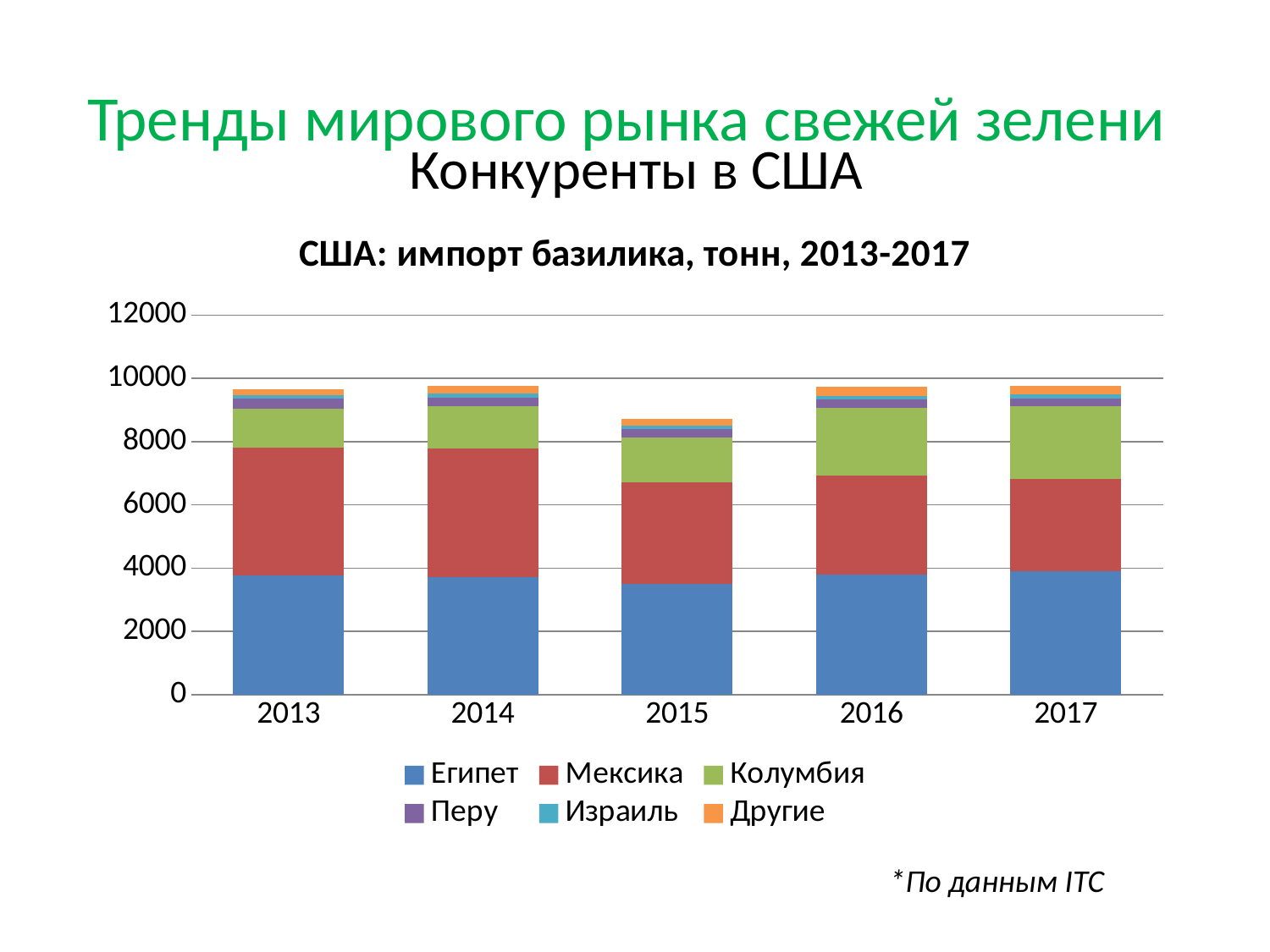
What kind of chart is shown on the slide? Stacked bar chart Which country forms the bottom segment of each stacked bar? Египет How many years are shown on the x axis of the chart? 5 Which year has the larger Колумбия segment, 2013 or 2017? 2017 Which year has the lowest total basil import? 2015 Is the total import for 2015 greater or less than 8000? greater Is the Египет segment for 2015 greater or less than 4000? less What is the title of the chart? США: импорт базилика, тонн, 2013-2017 Which year has the larger total import, 2015 or 2016? 2016 Which year has the larger Мексика segment, 2013 or 2017? 2013 How many series does the legend list? 6 Is the total import for 2015 greater or less than 10000? less